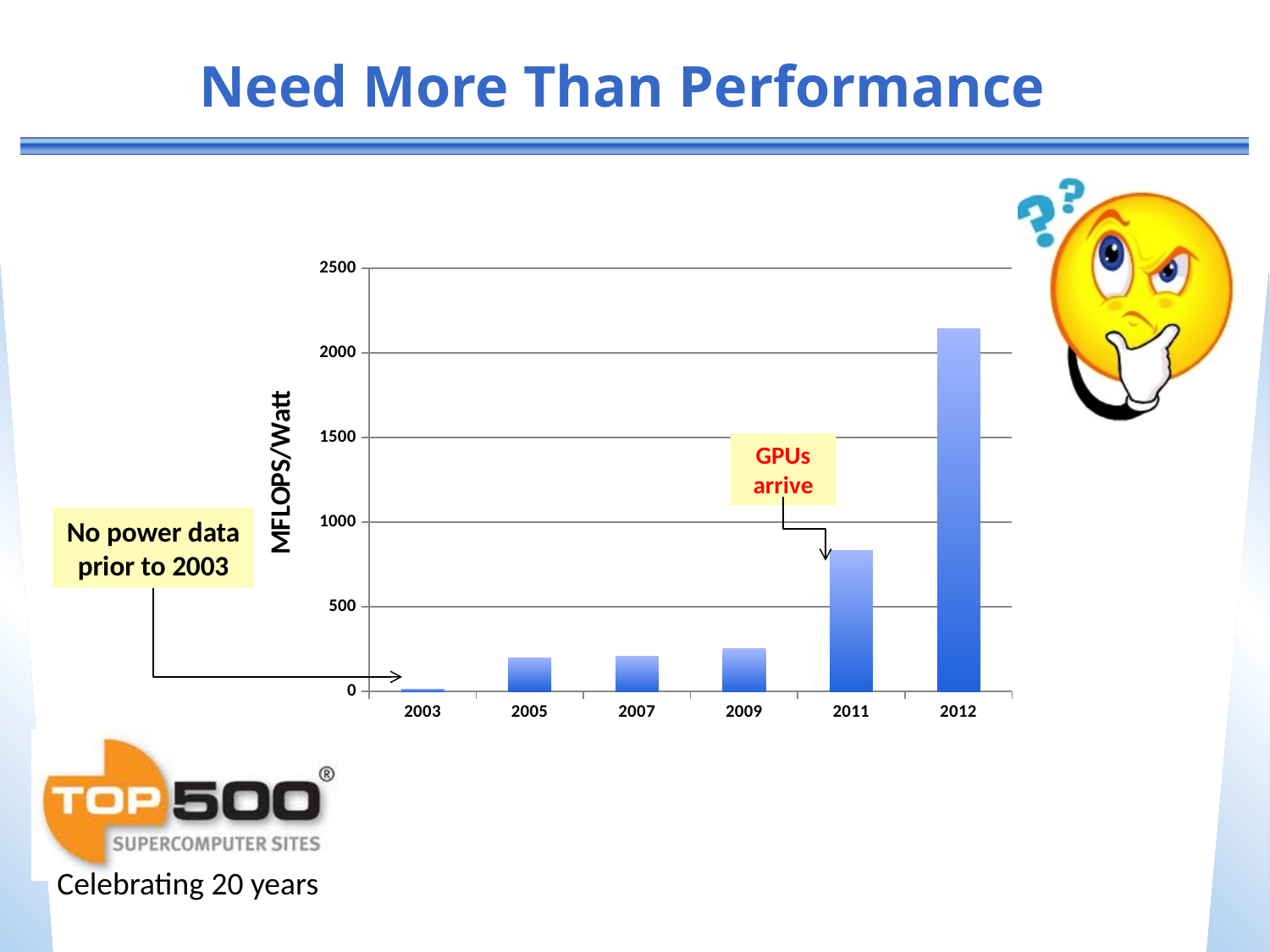
Do the values rise or fall from 2003 to 2012? rise Is the value for 2011 greater or less than 1000? less Is the value for 2011 greater or less than 500? greater Which year has the highest MFLOPS/Watt value? 2012 Which year has the lowest MFLOPS/Watt value? 2003 Which is larger, the value for 2012 or the value for 2011? 2012 Is the value for 2012 greater or less than 2000? greater Which is larger, the value for 2011 or the value for 2009? 2011 What is the label on the y axis of the chart? MFLOPS/Watt What kind of chart is shown on the slide? bar chart How many years are shown on the x axis of the chart? 6